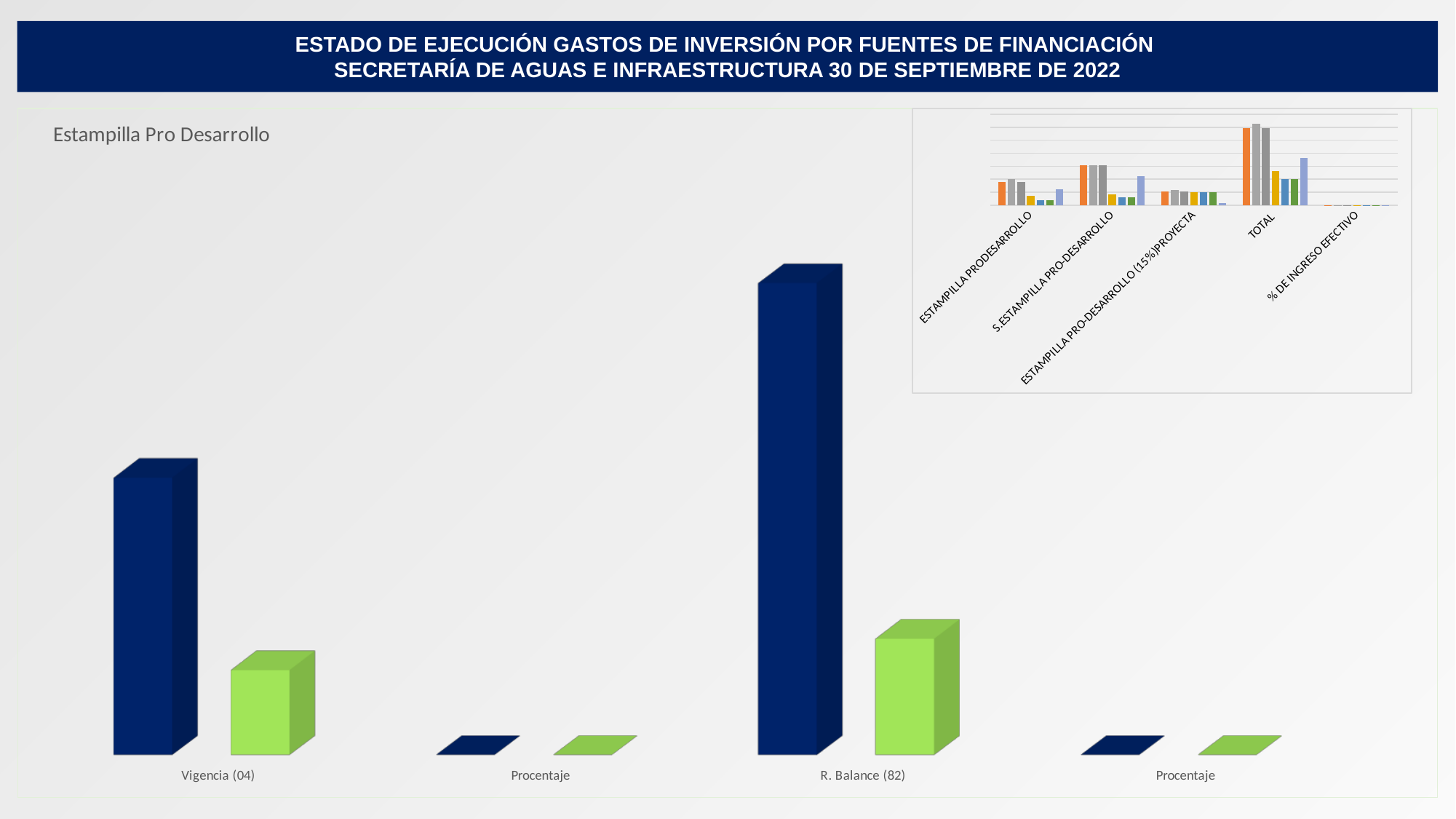
In the large chart "Estampilla Pro Desarrollo", how many categories are shown on the x axis? 4 In the large chart "Estampilla Pro Desarrollo", for the category Vigencia (04), which bar is taller, the dark blue one or the green one? dark blue In the large chart "Estampilla Pro Desarrollo", what colours are the two bar series? dark blue and green In the small inset chart in the top right, which category has the smallest bars? % DE INGRESO EFECTIVO What kind of chart is the large chart titled "Estampilla Pro Desarrollo"? bar chart What kind of chart is the small inset chart in the top right of the slide? bar chart In the large chart "Estampilla Pro Desarrollo", which category has the tallest dark blue bar? R. Balance (82) In the small inset chart in the top right, which category has the tallest bars? TOTAL In the large chart "Estampilla Pro Desarrollo", is the dark blue bar for Vigencia (04) taller or shorter than the dark blue bar for R. Balance (82)? shorter In the small inset chart in the top right, how many categories are shown on the x axis? 5 What is the title of the large chart on the left of the slide? Estampilla Pro Desarrollo In the large chart "Estampilla Pro Desarrollo", which category has the tallest green bar? R. Balance (82)